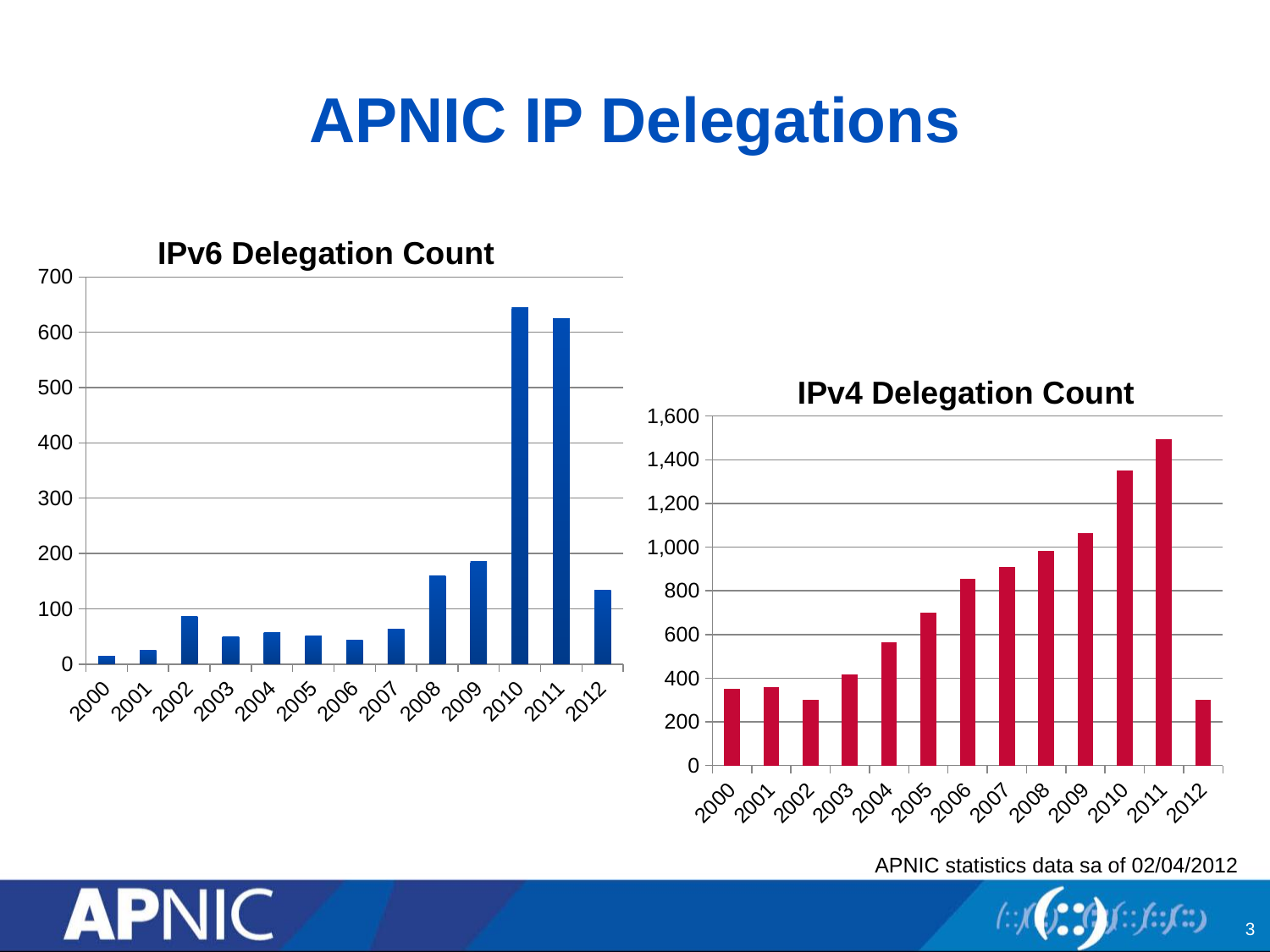
What kind of chart is the IPv6 Delegation Count chart? bar chart In the IPv6 Delegation Count chart, is the value for 2010 greater or less than 600? greater In the IPv4 Delegation Count chart, is the value for 2011 greater or less than 1,400? greater In the IPv4 Delegation Count chart, do the values generally rise or fall from 2002 to 2011? rise In the IPv6 Delegation Count chart, which year has the highest value? 2010 In the IPv4 Delegation Count chart, which year has the highest value? 2011 In the IPv6 Delegation Count chart, is the value for 2008 greater or less than 100? greater In the IPv6 Delegation Count chart, which year has the lowest value? 2000 What colour are the bars in the IPv4 Delegation Count chart? red How many years are shown on the x axis of the IPv6 Delegation Count chart? 13 In the IPv4 Delegation Count chart, which year has the larger value, 2009 or 2010? 2010